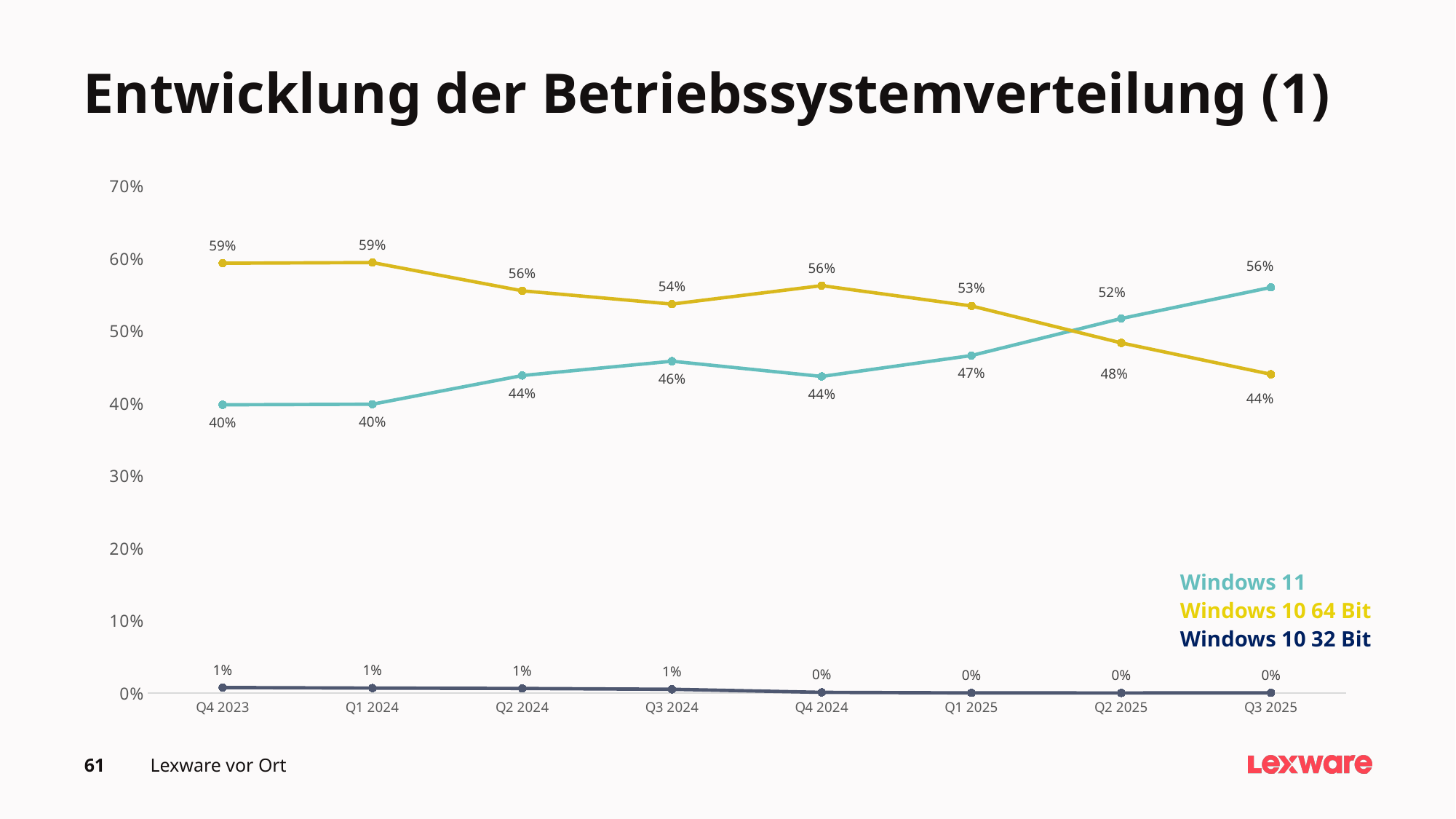
Does the Windows 10 64 Bit line generally rise or fall from Q4 2023 to Q3 2025? fall What kind of chart is shown on the slide? line chart In which quarter does Windows 10 64 Bit have its lowest value? Q3 2025 How many series does the legend list? 3 What is the difference between Windows 10 64 Bit and Windows 11 in Q4 2023? 19% How many quarters are plotted along the x axis? 8 What is the value for Windows 10 64 Bit in Q4 2023? 59% What is the value for Windows 11 in Q3 2025? 56% In which quarter does Windows 11 reach its highest value? Q3 2025 What is the title of the chart on the slide? Entwicklung der Betriebssystemverteilung (1) What is the value for Windows 10 32 Bit in Q2 2024? 1% Which is larger in Q2 2025, Windows 11 or Windows 10 64 Bit? Windows 11